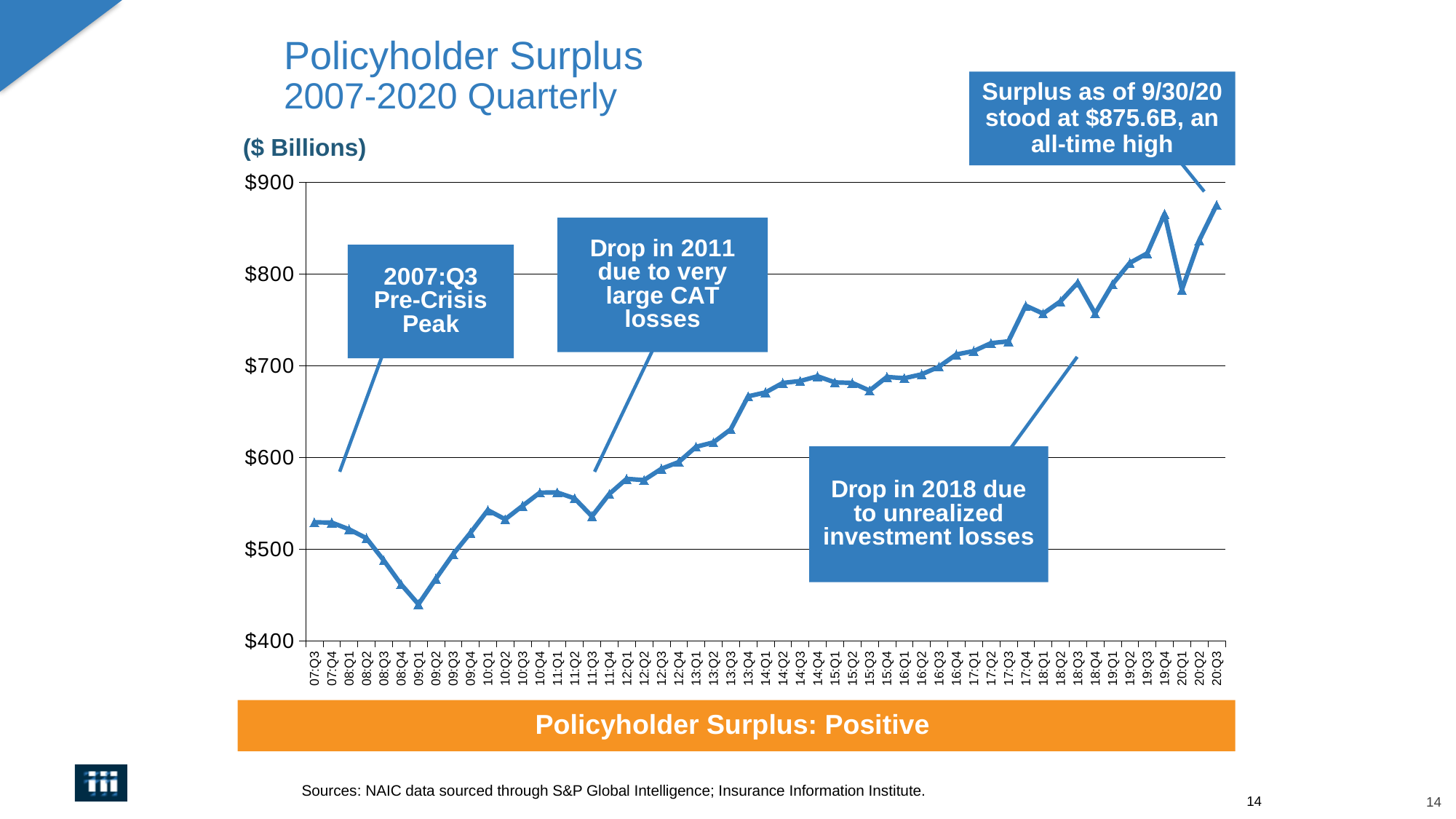
Which quarter has the lowest policyholder surplus on the chart? 09:Q1 Which is larger, the surplus in 07:Q3 or in 20:Q3? 20:Q3 What was the policyholder surplus as of 9/30/20 according to the annotation? $875.6B Overall, does the policyholder surplus rise or fall from 07:Q3 to 20:Q3? Rise Is the value for 11:Q3 greater or less than $600? less In what unit are the values on the y-axis expressed? $ Billions Is the value for 20:Q1 greater or less than $800? less What kind of chart is shown on the slide? Line chart According to the annotation, what caused the drop in 2018? Unrealized investment losses Is the value for 18:Q3 greater or less than $700? greater Which quarter has the highest policyholder surplus on the chart? 20:Q3